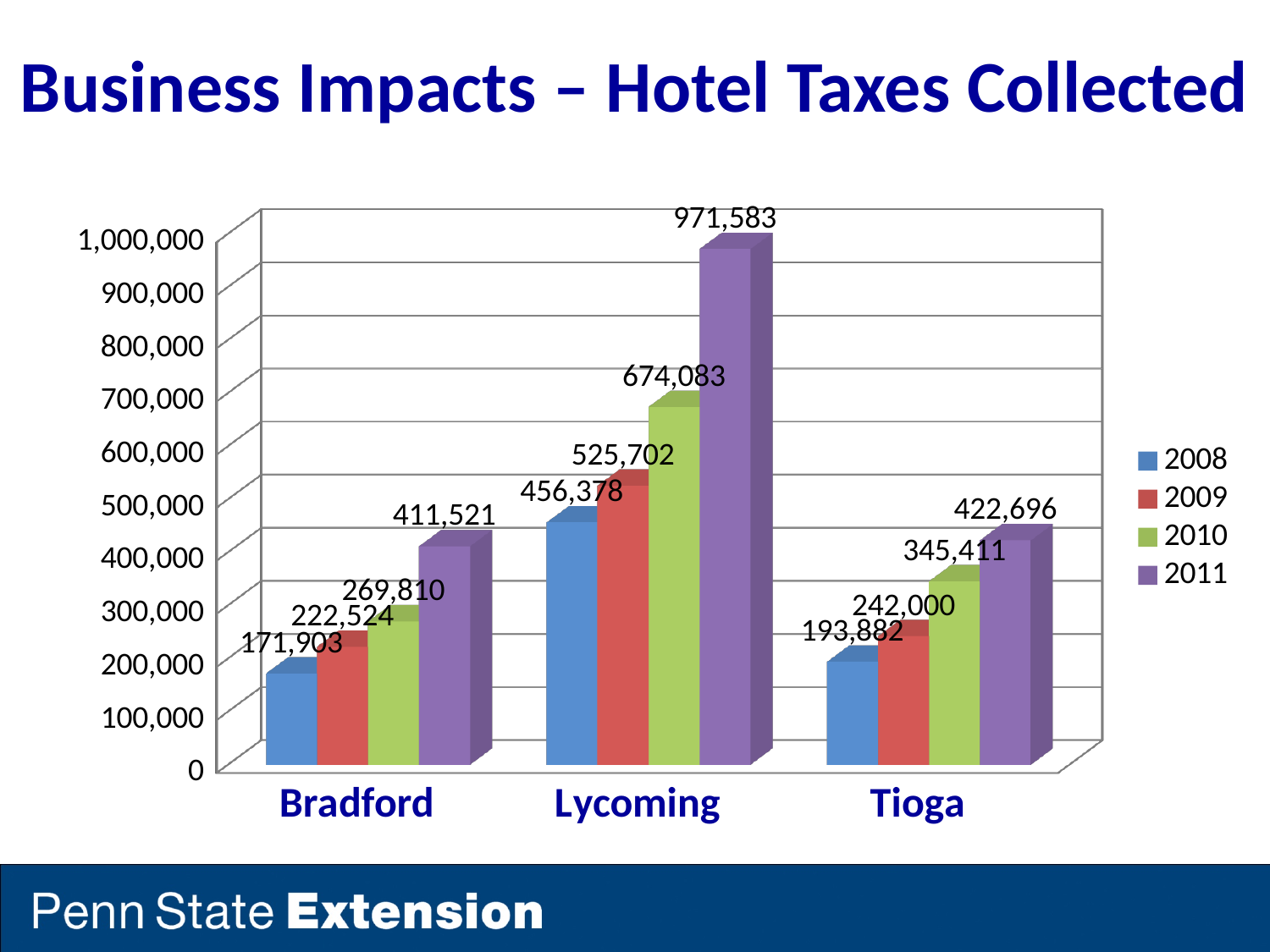
What was the hotel tax collected in Tioga in 2010? 345,411 Which county had the highest hotel taxes collected in 2011? Lycoming What was the hotel tax collected in Lycoming in 2011? 971,583 How much more hotel tax did Lycoming collect in 2011 than in 2010? 297,500 Which collected more hotel tax in 2010, Bradford or Tioga? Tioga Which county had the lowest hotel taxes collected in 2009? Bradford Is the value for Lycoming in 2009 greater or less than 500,000? greater How many years does the legend list? 4 How many counties are shown on the x axis? 3 What is the difference between Bradford's 2011 and 2008 hotel tax collections? 239,618 What was the hotel tax collected in Bradford in 2008? 171,903 What kind of chart is shown on the slide? Bar chart